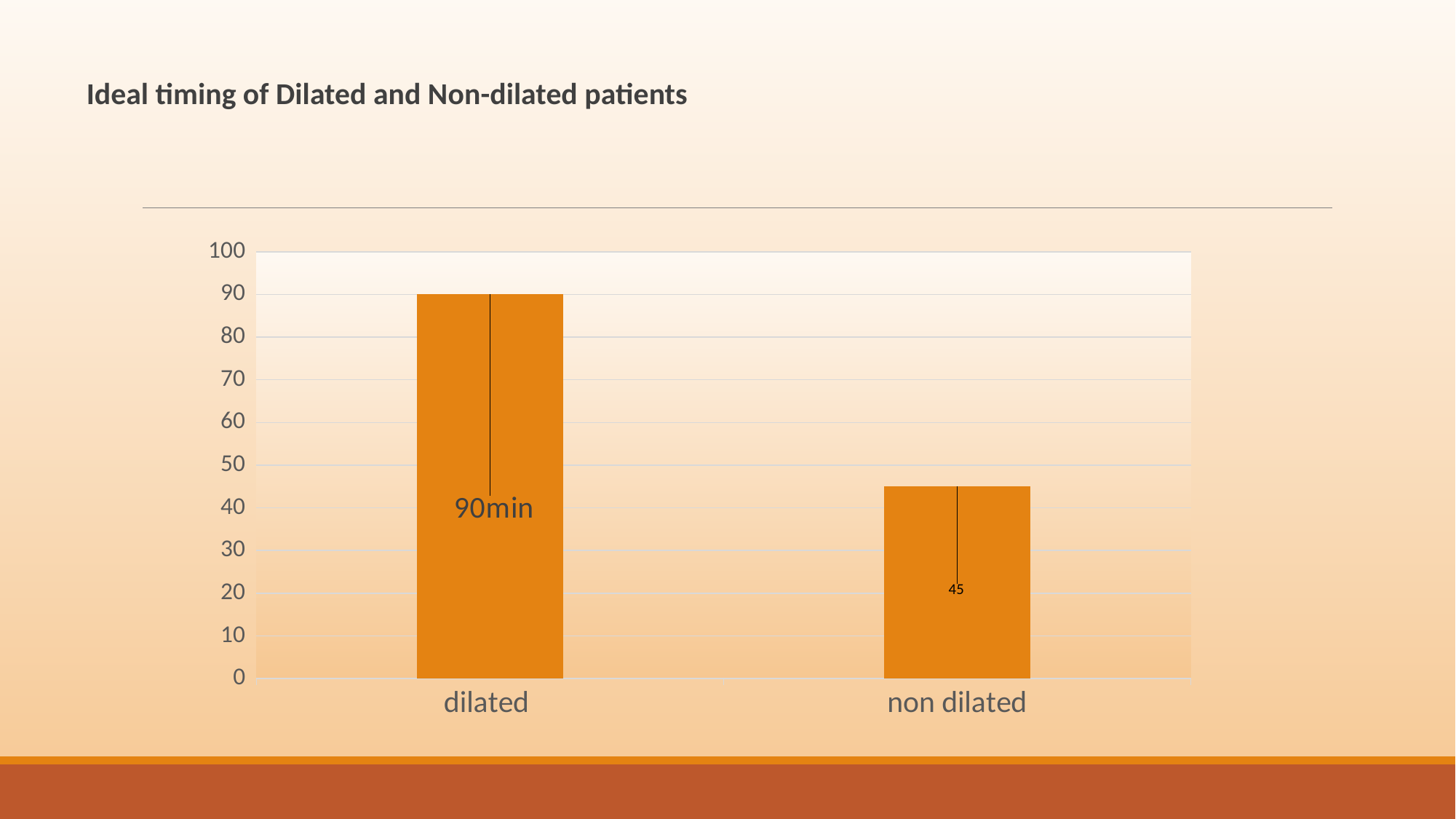
What is the value shown for the non dilated category? 45 Which category has the lowest value? non dilated What is the maximum value shown on the y axis? 100 What kind of chart is shown on the slide? bar chart Which category has the highest value? dilated Is the value for dilated greater or less than 80? greater Which is larger, the value for dilated or for non dilated? dilated What is the difference between the dilated and non dilated values? 45 What is the title of the slide? Ideal timing of Dilated and Non-dilated patients How many categories are shown on the x axis? 2 Is the value for non dilated greater or less than 50? less What is the value shown for the dilated category? 90min